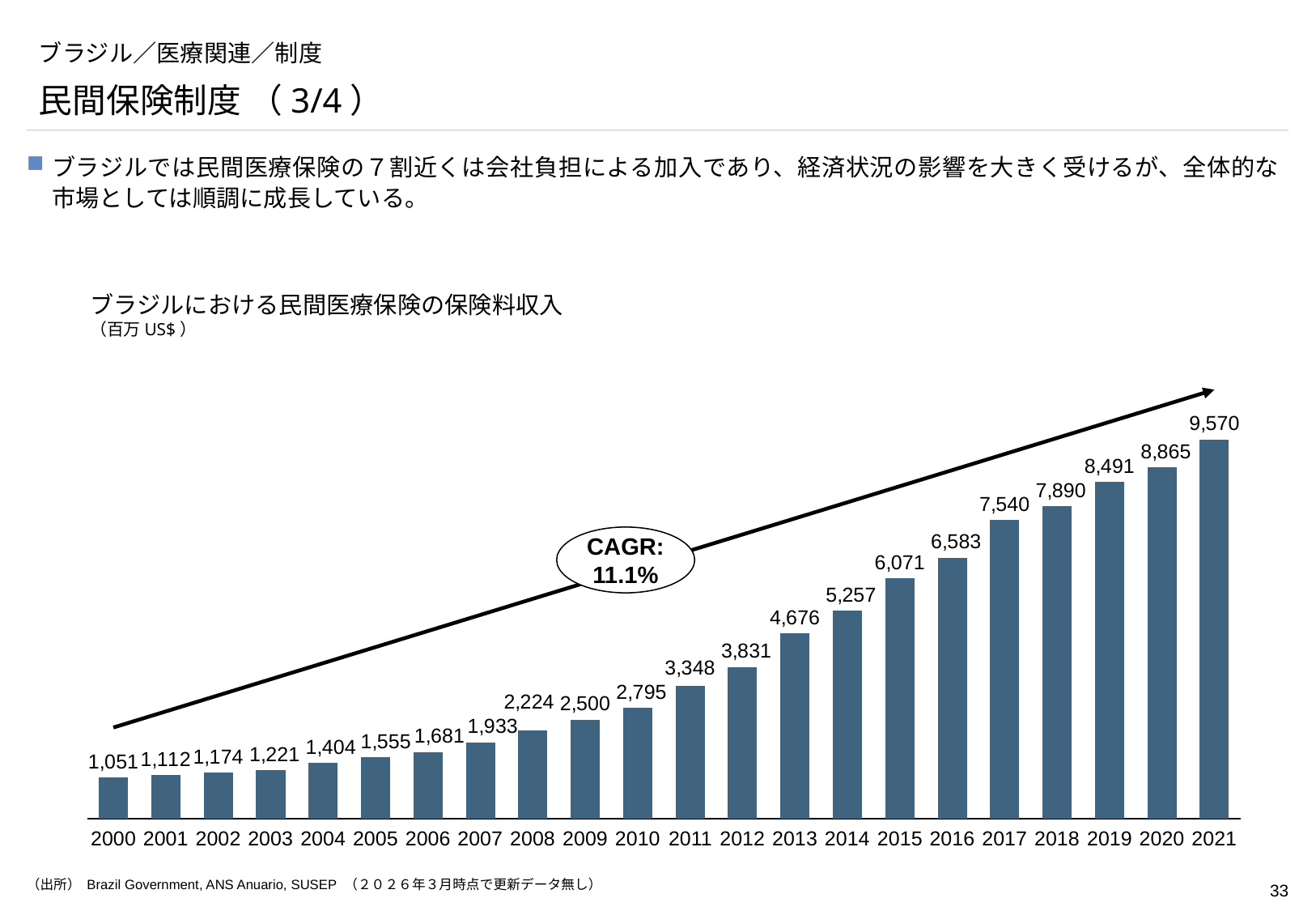
Which year has the lowest premium income? 2000 Which year has the highest premium income? 2021 What is the premium income value shown for 2000? 1,051 Which is larger, the value for 2015 or the value for 2014? 2015 What is the difference between the values for 2010 and 2009? 295 What CAGR is shown in the oval on the chart? 11.1% What is the premium income value shown for 2021? 9,570 What is the difference between the values for 2021 and 2020? 705 What kind of chart is shown on the slide? Bar chart What is the value shown for 2013? 4,676 Do the values rise or fall from 2000 to 2021? Rise How many years are plotted on the chart? 22